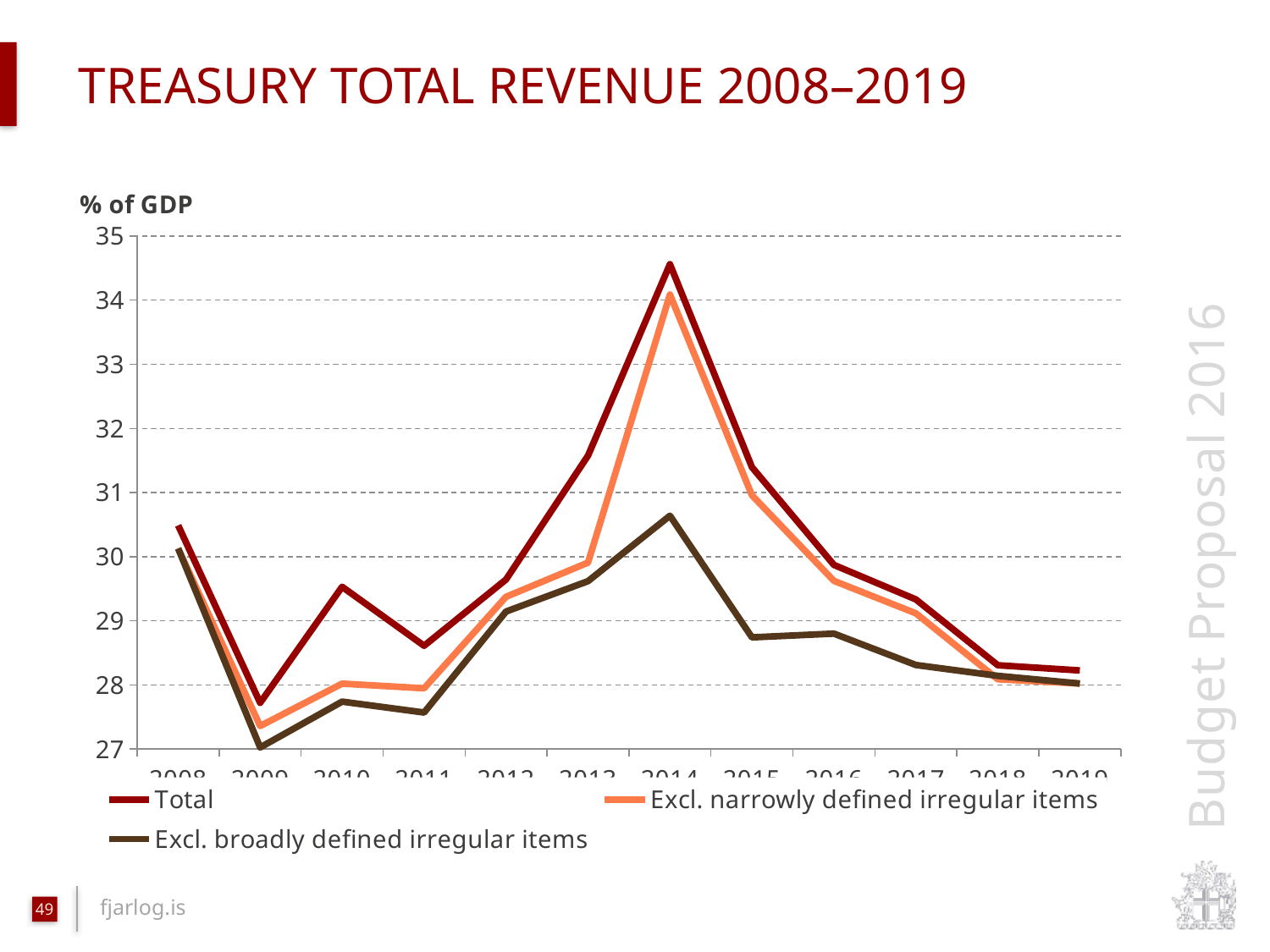
Is the value for Total in 2014 greater or less than 34? greater Is the value for Total in 2009 greater or less than 28? less In 2014, which is larger: Total or Excl. broadly defined irregular items? Total How many years are plotted along the x axis? 12 In which year does the Total series reach its lowest value? 2009 In which year does the Total series reach its highest value? 2014 What kind of chart is shown on the slide? line chart Does the Total series rise or fall from 2014 to 2019? fall Is the value for Excl. broadly defined irregular items in 2014 greater or less than 30? greater How many series does the legend list? 3 What unit is shown above the y axis? % of GDP